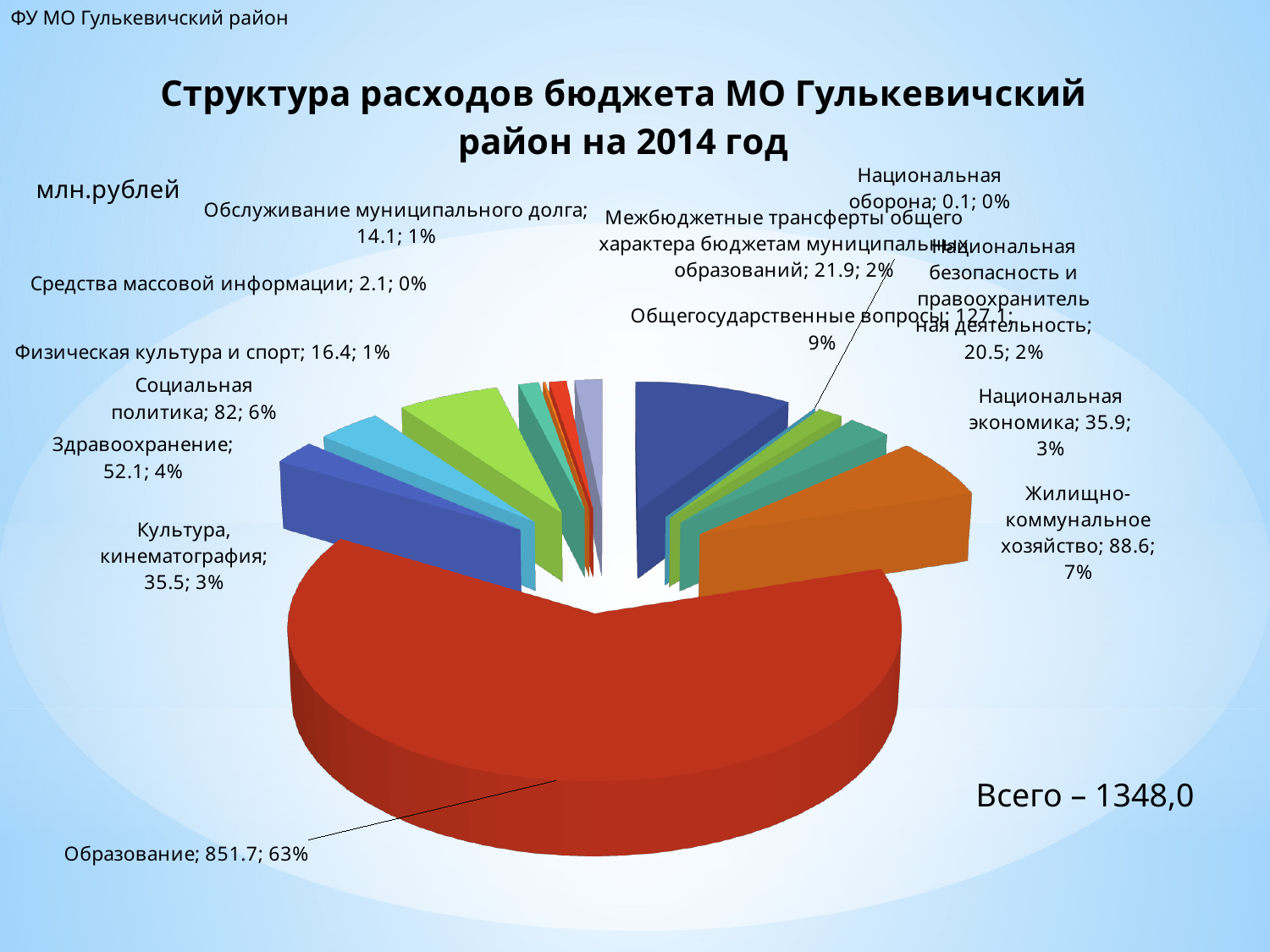
What is the value for Здравоохранение? 52.1 Which is larger, Социальная политика or Здравоохранение? Социальная политика Which category has the smallest value? Национальная оборона How many categories are shown in the pie chart? 13 What is the value for Образование? 851.7 What is the value for Жилищно-коммунальное хозяйство? 88.6 What total is stated on the slide for the budget expenditures? 1348,0 What share of the pie does Образование take? 63% What kind of chart is shown on the slide? pie chart Which category has the largest value? Образование What is the difference between the values for Жилищно-коммунальное хозяйство and Социальная политика? 6.6 What share of the pie does Общегосударственные вопросы take? 9%